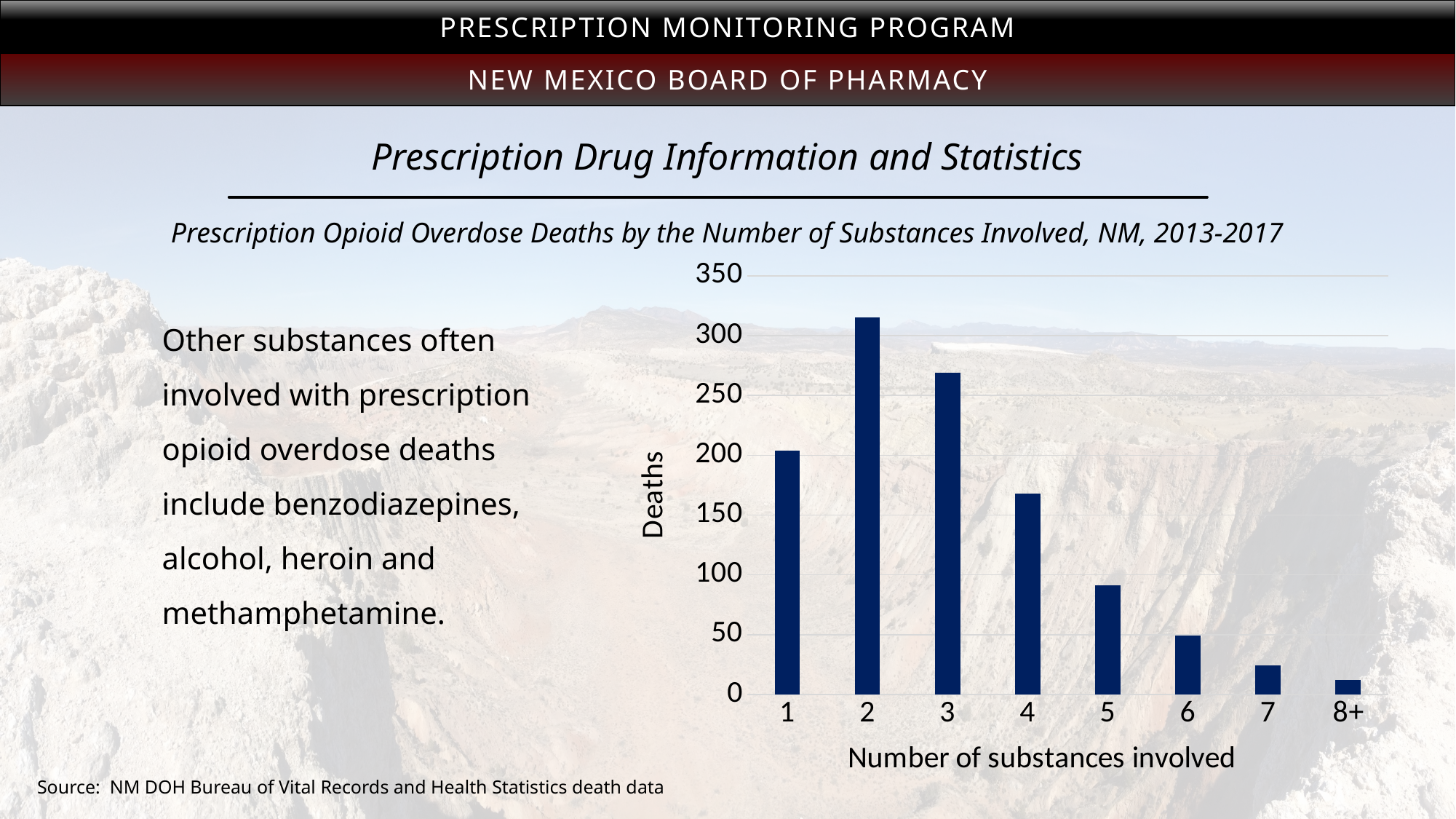
What is the label of the y axis of the chart? Deaths What kind of chart is shown on the slide? bar chart Is the number of deaths for 3 substances involved greater or less than 250? greater Is the number of deaths for 4 substances involved greater or less than 150? greater Which number of substances involved has the highest number of deaths? 2 How many categories are shown on the x axis of the chart? 8 Which number of substances involved has the lowest number of deaths? 8+ Which has more deaths: 1 substance involved or 3 substances involved? 3 From 2 substances onward, do the deaths rise or fall as the number of substances involved increases? fall Is the number of deaths for 5 substances involved greater or less than 100? less